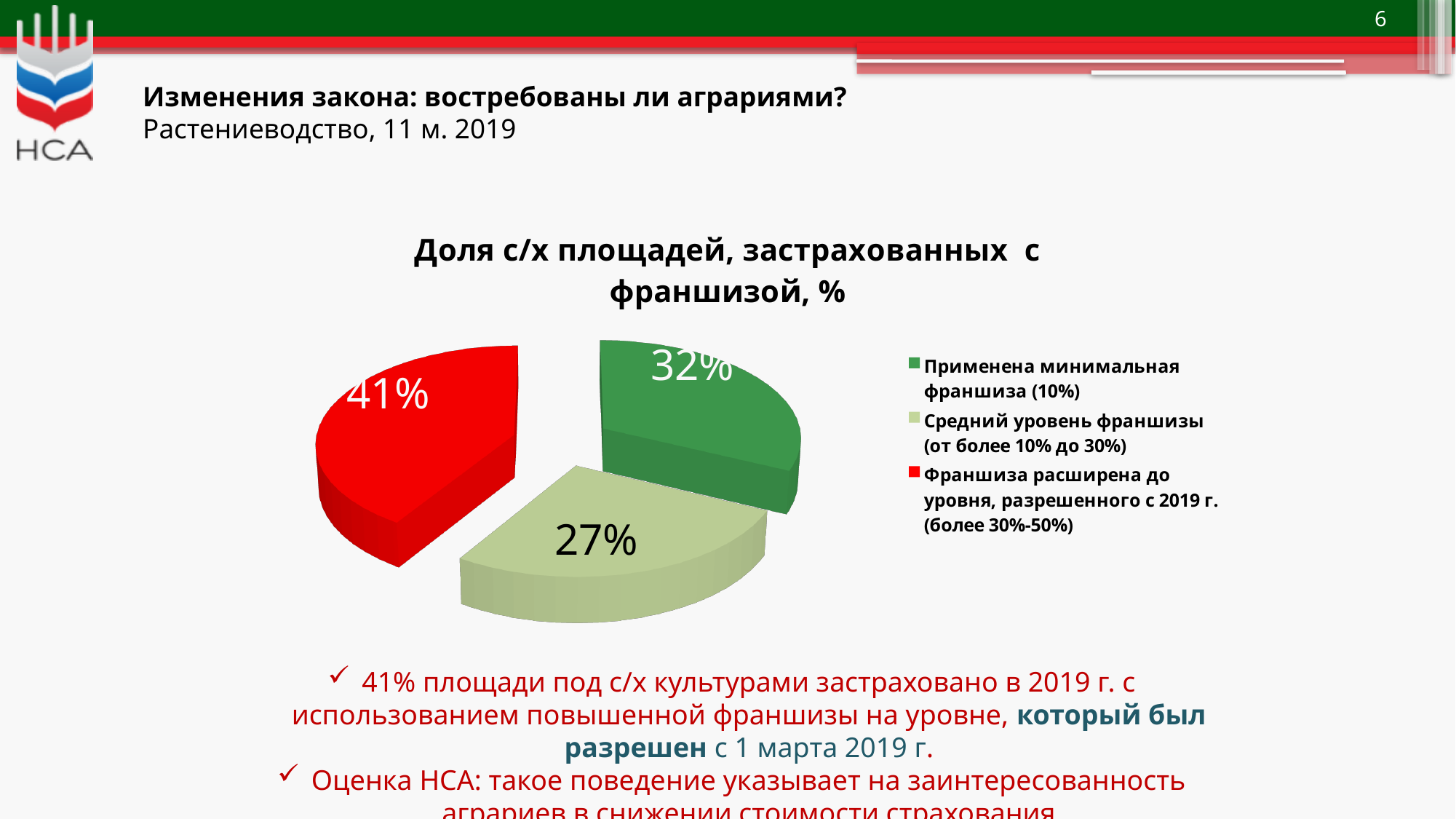
What is the title of the chart? Доля с/х площадей, застрахованных с франшизой, % What colour is the slice representing 'Франшиза расширена до уровня, разрешенного с 2019 г. (более 30%-50%)'? Red How many slices does the pie chart have? 3 Which category has the largest share of the pie? Франшиза расширена до уровня, разрешенного с 2019 г. (более 30%-50%) How many entries does the legend list? 3 Which category has the smallest share of the pie? Средний уровень франшизы (от более 10% до 30%) Which is larger: the share for 'Применена минимальная франшиза (10%)' or the share for 'Средний уровень франшизы (от более 10% до 30%)'? Применена минимальная франшиза (10%) What share of the pie is labelled 'Средний уровень франшизы (от более 10% до 30%)'? 27% What share of the pie is labelled 'Применена минимальная франшиза (10%)'? 32% What type of chart is shown on the slide? Pie chart What share of the pie is labelled 'Франшиза расширена до уровня, разрешенного с 2019 г. (более 30%-50%)'? 41% What is the difference in percentage points between the red slice (41%) and the dark green slice (32%)? 9